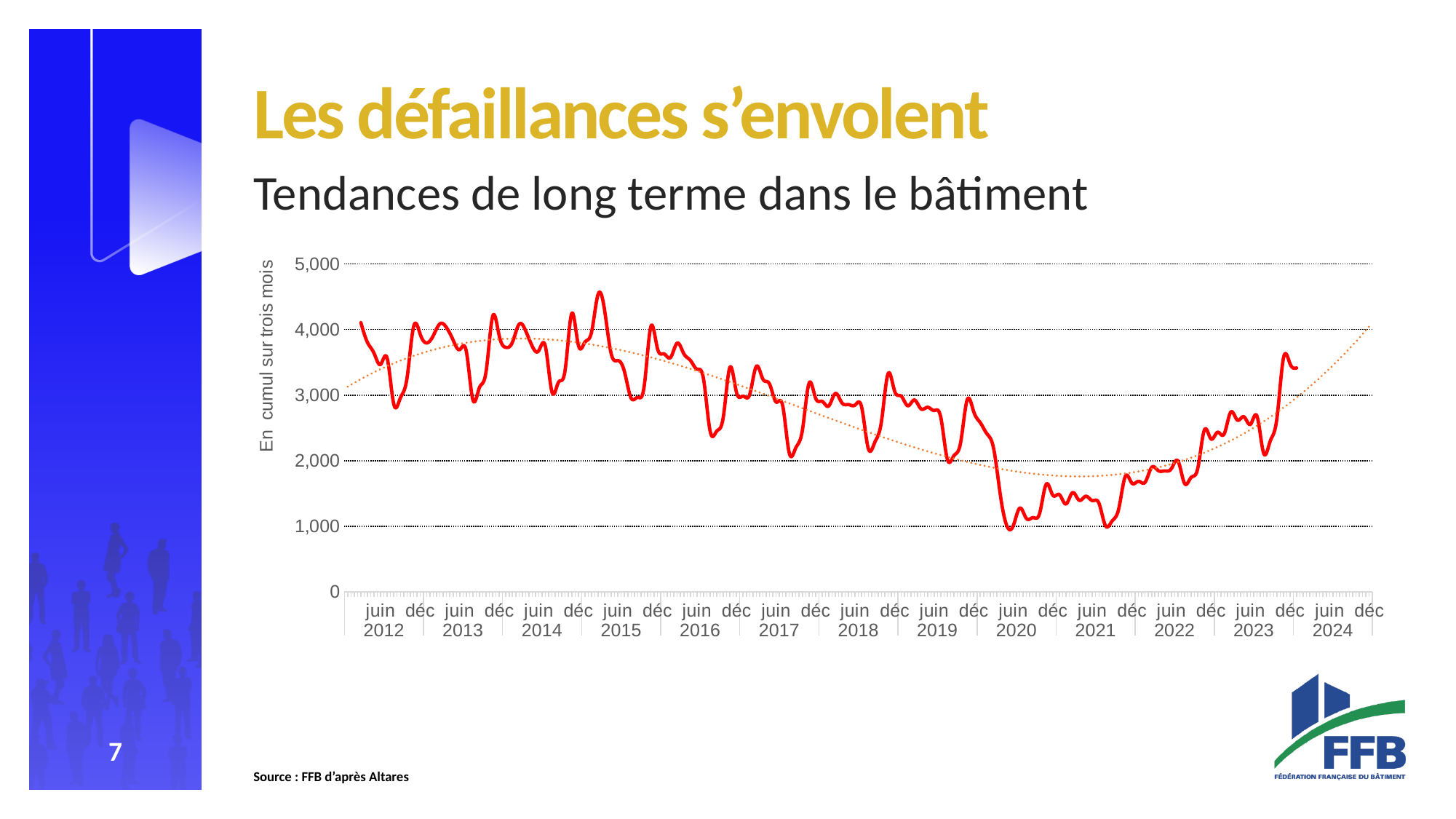
Is the value of the red line at déc 2023 greater or less than 3,000? greater In which year does the red line reach its highest point? 2015 What kind of chart is shown on the slide? line chart Is the value of the red line at déc 2020 greater or less than 2,000? less Is the value of the red line at juin 2015 greater or less than 4,000? less What source is cited below the chart? FFB d'après Altares Do the values of the red line rise or fall between 2015 and 2020? fall How many years are labelled along the x axis of the chart? 13 Do the values of the red line rise or fall between 2021 and 2023? rise What is the label of the vertical axis of the chart? En cumul sur trois mois